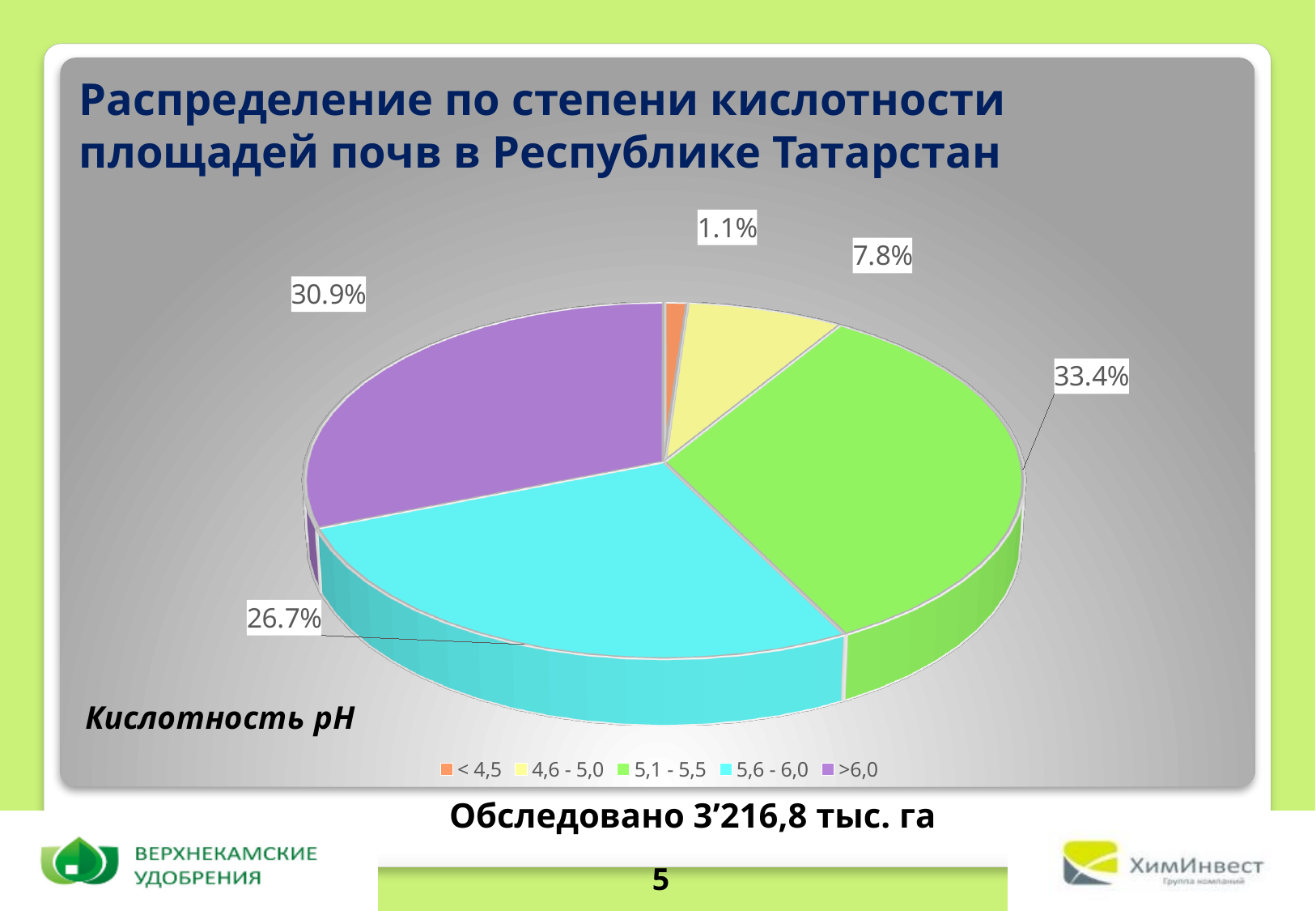
What colour is the slice for the >6,0 pH category? purple How many categories does the pie chart have? 5 What kind of chart is shown on the slide? pie chart What share of the soil area has a pH below 4,5? 1.1% What share of the soil area has a pH greater than 6,0? 30.9% What is the difference in percentage points between the 5,1 - 5,5 slice and the 5,6 - 6,0 slice? 6.7 Which pH category has the smallest share of the pie? < 4,5 What share of the soil area has a pH of 5,6 - 6,0? 26.7% Which pH category has the largest share of the pie? 5,1 - 5,5 What share of the soil area has a pH of 5,1 - 5,5? 33.4% What share of the soil area has a pH of 4,6 - 5,0? 7.8% Which slice is larger: >6,0 or 5,6 - 6,0? >6,0